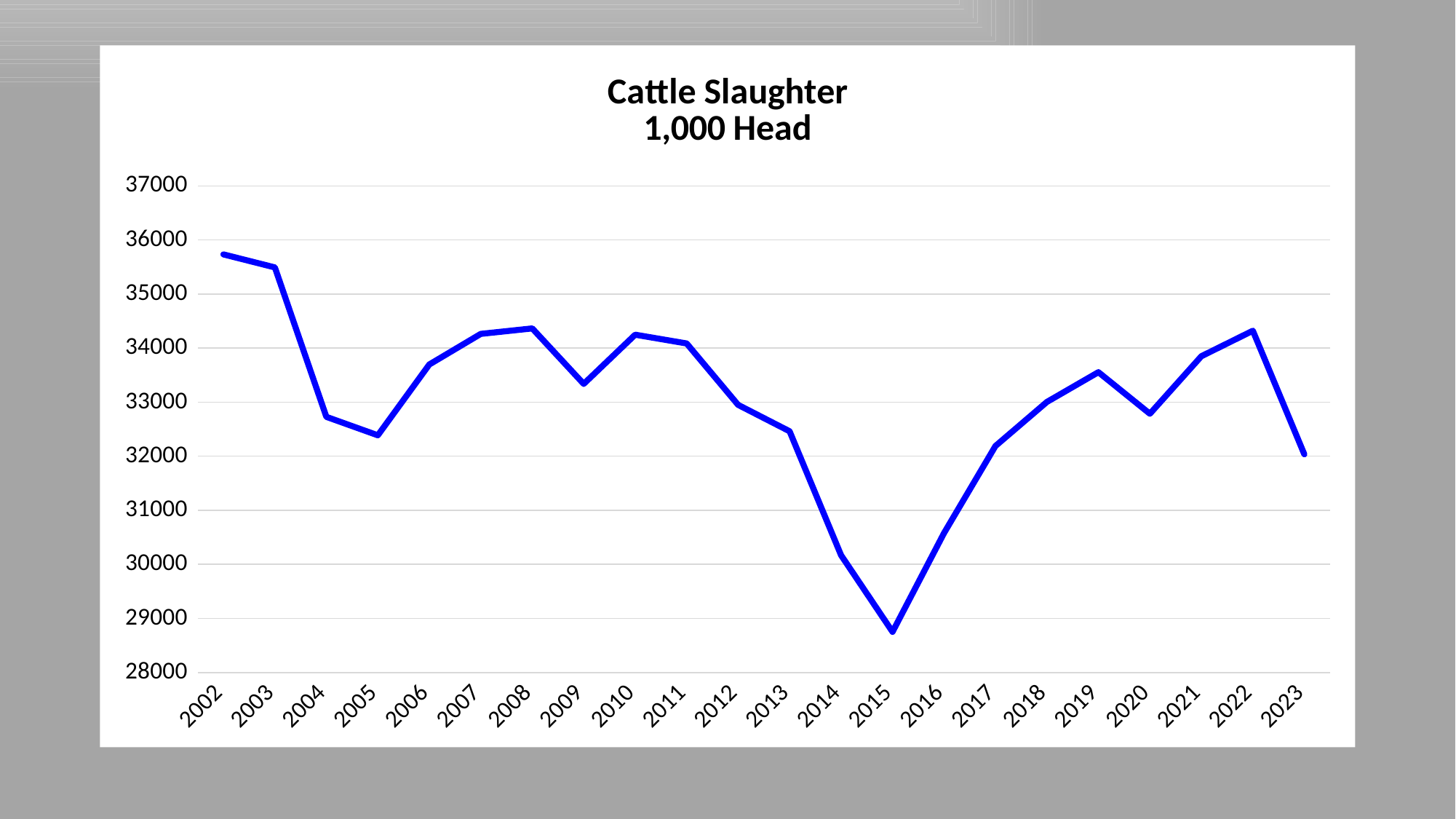
What kind of chart is shown on the slide? line chart Do the values rise or fall from 2015 to 2019? rise What is the title of the chart? Cattle Slaughter 1,000 Head How many years are plotted along the x axis? 22 Is the value for 2019 greater or less than 33000? greater Which year has the lowest cattle slaughter value? 2015 Is the value for 2020 greater or less than 33000? less Which year has the larger value, 2022 or 2023? 2022 Which year has the larger value, 2005 or 2006? 2006 Is the value for 2008 greater or less than 34000? greater Which year has the highest cattle slaughter value? 2002